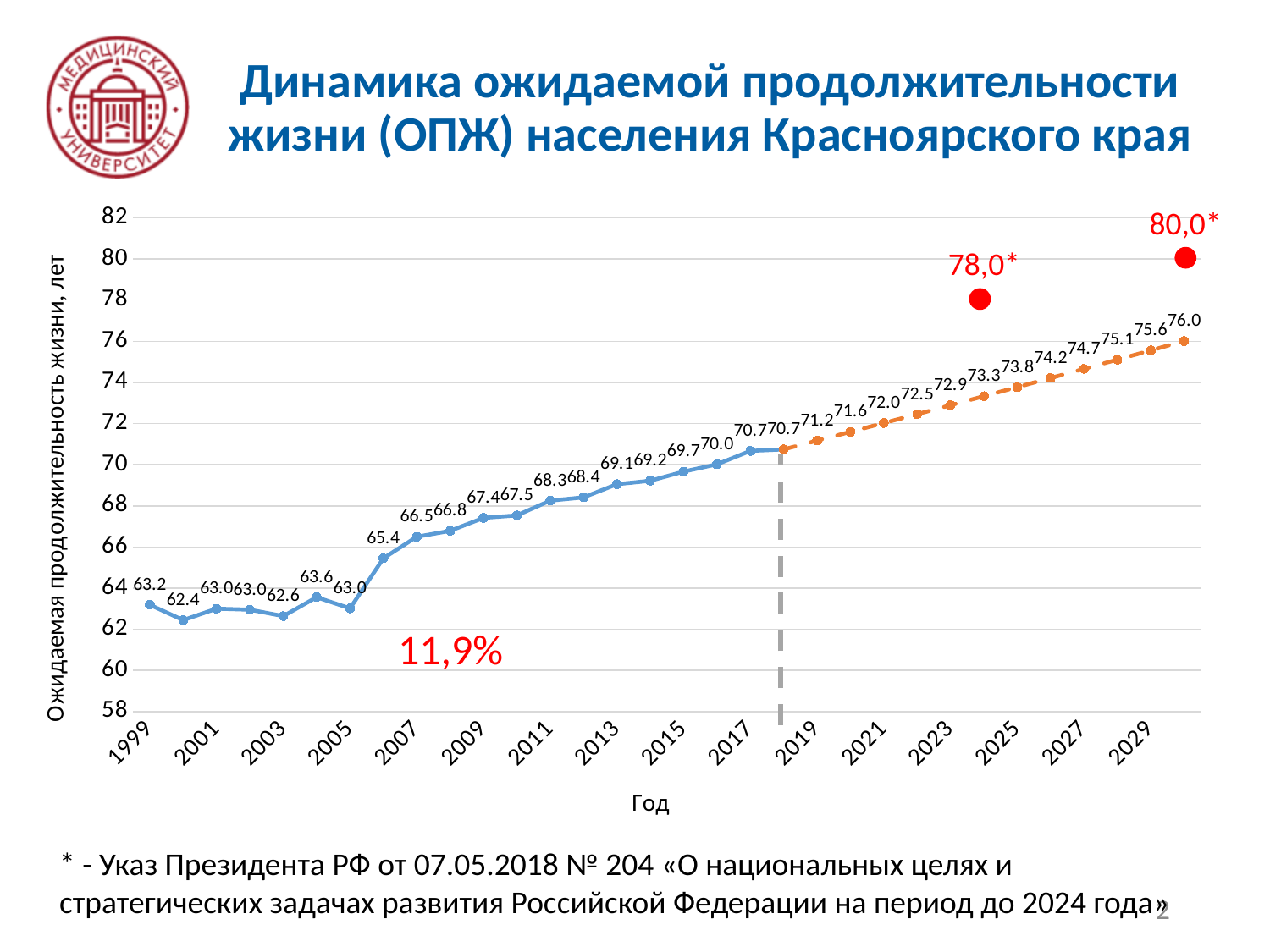
What value is labelled next to the red dot at 2030? 80,0* What is the life expectancy value shown for 2029? 75.6 What is the life expectancy value shown for 2023? 72.9 What kind of chart is shown on the slide? line chart What is the life expectancy value shown for 2017? 70.7 Is the value for 2013 greater or less than 70? less What is the highest value labelled on the dashed orange line? 76.0 Which year has the higher value, 2005 or 2007? 2007 What is the lowest value labelled on the line? 62.4 By how much does the value for 2017 exceed the value for 1999? 7.5 What is the life expectancy value shown for 1999? 63.2 Do the values generally rise or fall from 2005 to 2030? rise